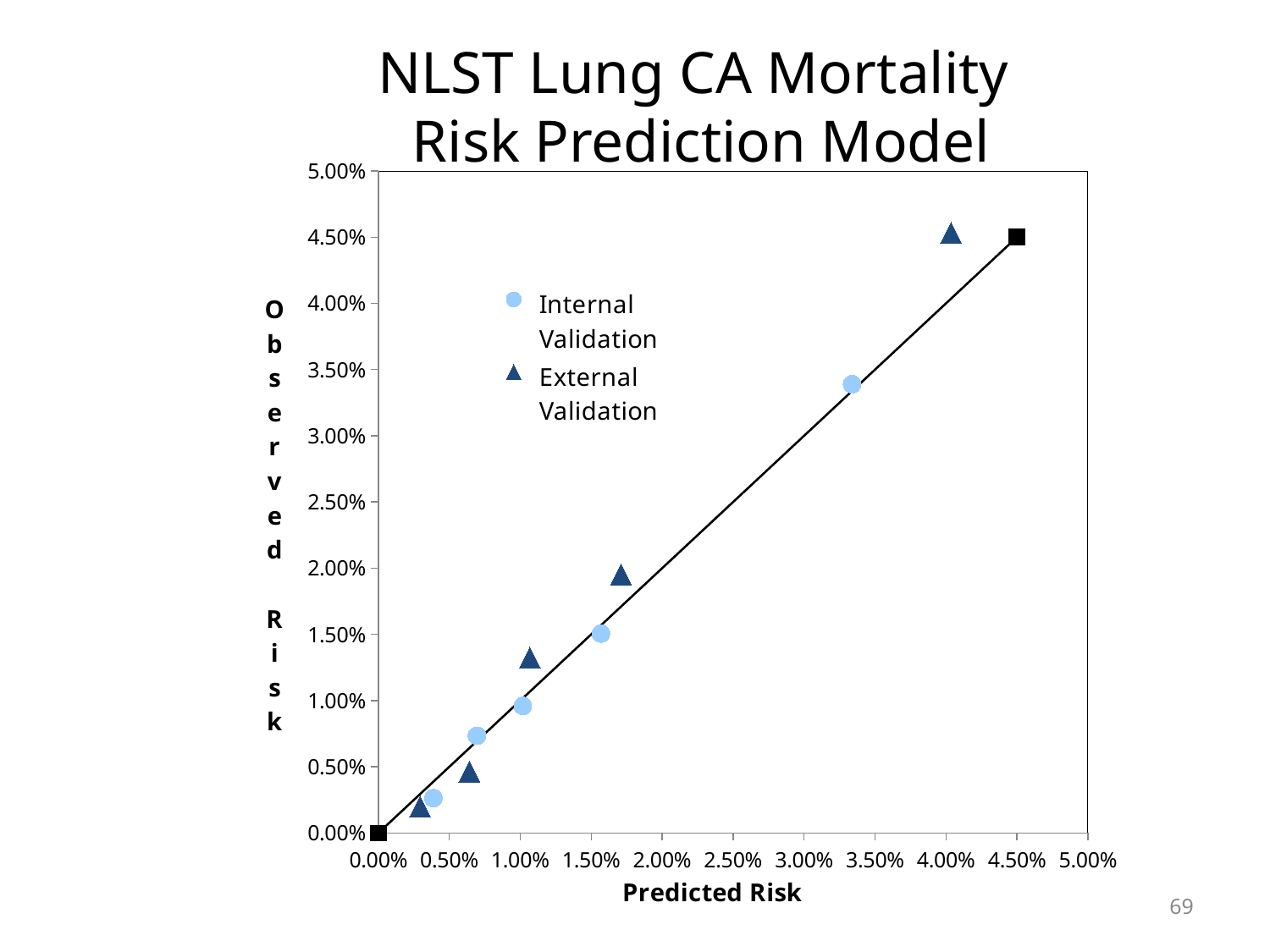
Is the observed risk of the highest Internal Validation point greater or less than 3.50%? less Which series contains the point with the highest observed risk? External Validation What is the title of the chart? NLST Lung CA Mortality Risk Prediction Model Is the observed risk of the highest External Validation point greater or less than 4.00%? greater As predicted risk increases along the x axis, does observed risk rise or fall? rise What kind of chart is shown on the slide? Scatter chart Is the observed risk of the lowest Internal Validation point greater or less than 0.50%? less How many External Validation points are plotted? 5 What are the two series named in the legend? Internal Validation and External Validation How many series does the legend list? 2 How many Internal Validation points are plotted? 5